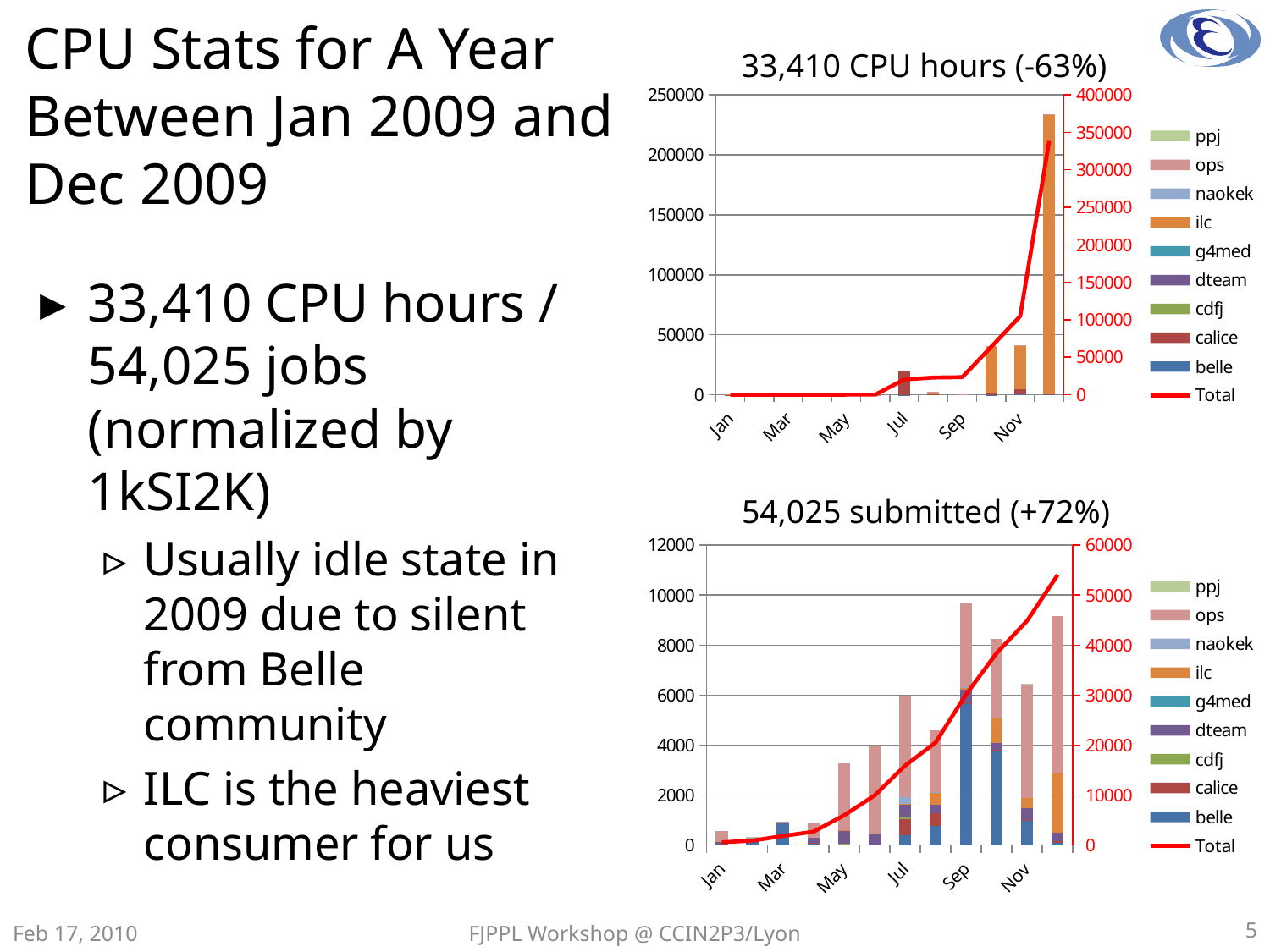
In the bottom chart "54,025 submitted (+72%)", does the Total line rise or fall from Jan to Dec? rise In the top chart "33,410 CPU hours (-63%)", is the Total line value for Dec greater or less than 300000 on the right axis? greater In the top chart "33,410 CPU hours (-63%)", is the bar for Jul greater or less than 50000 on the left axis? less What is the title of the top chart on the slide? 33,410 CPU hours (-63%) What kind of chart is the top chart titled "33,410 CPU hours (-63%)"? bar and line chart In the top chart "33,410 CPU hours (-63%)", is the bar for Dec greater or less than 200000 on the left axis? greater How many series does the legend of the bottom chart "54,025 submitted (+72%)" list? 10 In the top chart "33,410 CPU hours (-63%)", which month has the highest bar? Dec In the bottom chart "54,025 submitted (+72%)", which bar is taller, Sep or Oct? Sep In the bottom chart "54,025 submitted (+72%)", which month has the highest bar? Sep